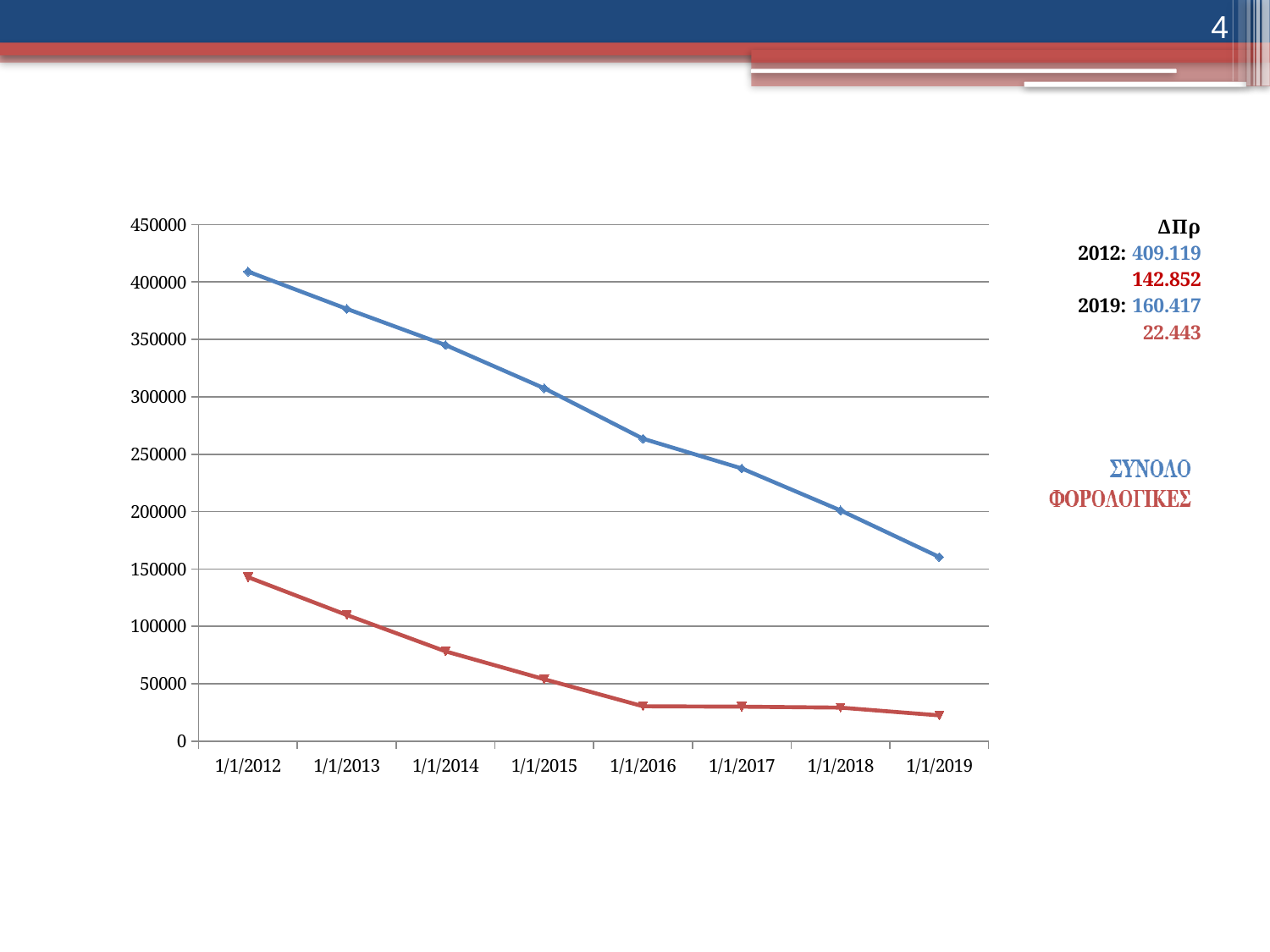
Do the ΣΥΝΟΛΟ values rise or fall from 1/1/2012 to 1/1/2019? fall What kind of chart is shown on the slide? line chart What is the value of ΣΥΝΟΛΟ for 2012? 409.119 How many data points does each line have along the x axis? 8 At 1/1/2016, which series has the larger value, ΣΥΝΟΛΟ or ΦΟΡΟΛΟΓΙΚΕΣ? ΣΥΝΟΛΟ Is the ΣΥΝΟΛΟ value at 1/1/2018 greater or less than 250000? less What is the value of ΦΟΡΟΛΟΓΙΚΕΣ for 2012? 142.852 By how much did ΣΥΝΟΛΟ decrease from 2012 to 2019? 248.702 What is the value of ΦΟΡΟΛΟΓΙΚΕΣ for 2019? 22.443 Which year has the highest ΣΥΝΟΛΟ value? 1/1/2012 Is the ΦΟΡΟΛΟΓΙΚΕΣ value at 1/1/2013 greater or less than 100000? greater